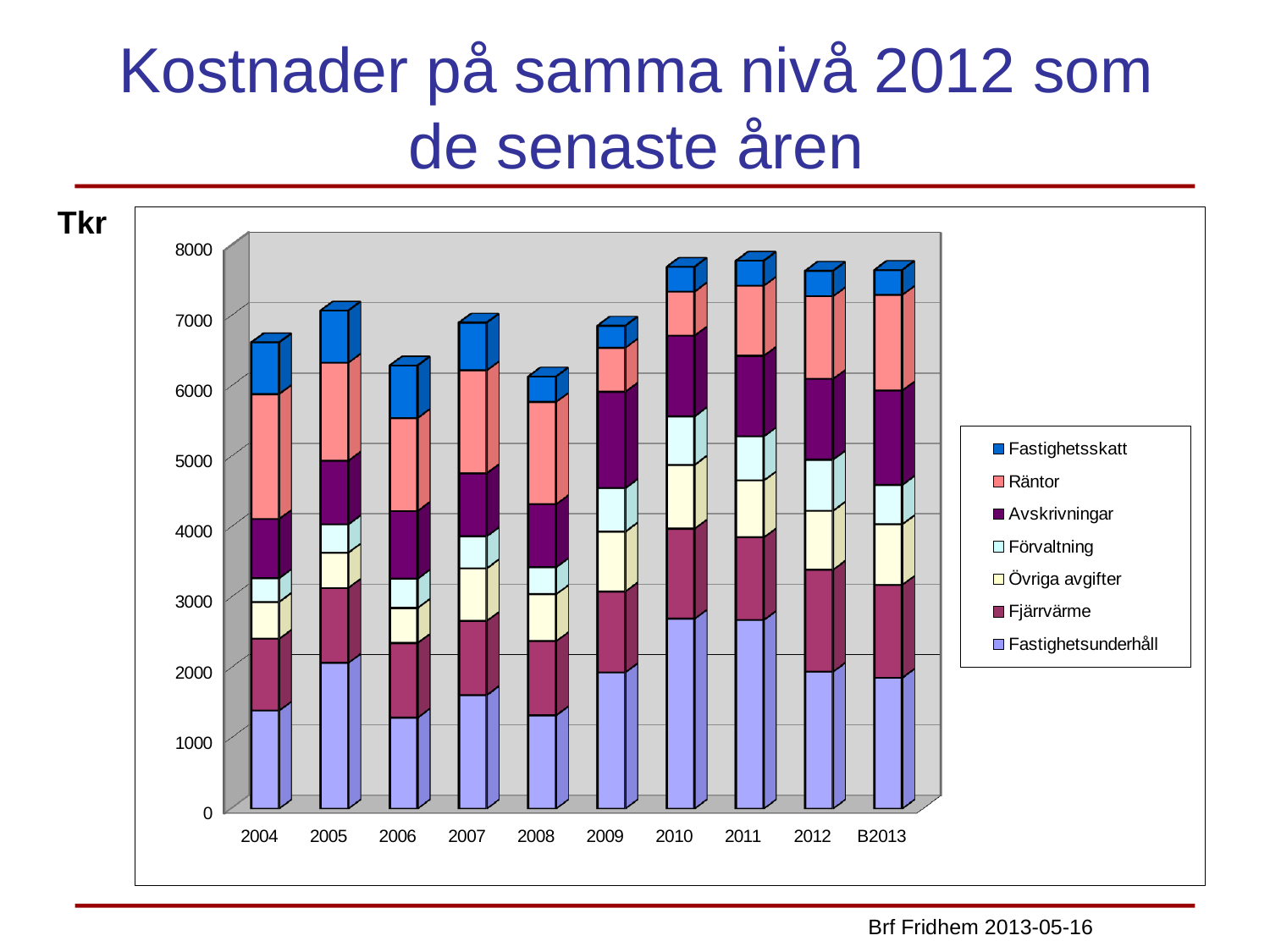
What kind of chart is shown on the slide? Stacked bar chart How many series does the chart's legend list? 7 Which has the larger total stacked value, 2010 or 2006? 2010 Is the Fastighetsunderhåll value for 2004 greater or less than 2000? less Is the Fastighetsunderhåll value for 2010 greater or less than 2000? greater How many years (categories) are shown on the x axis of the chart? 10 Which series is listed first (at the top) in the chart's legend? Fastighetsskatt What is the title of the slide containing the chart? Kostnader på samma nivå 2012 som de senaste åren Is the total stacked value for 2004 greater or less than 6000? greater Which has the larger total stacked value, 2005 or 2008? 2005